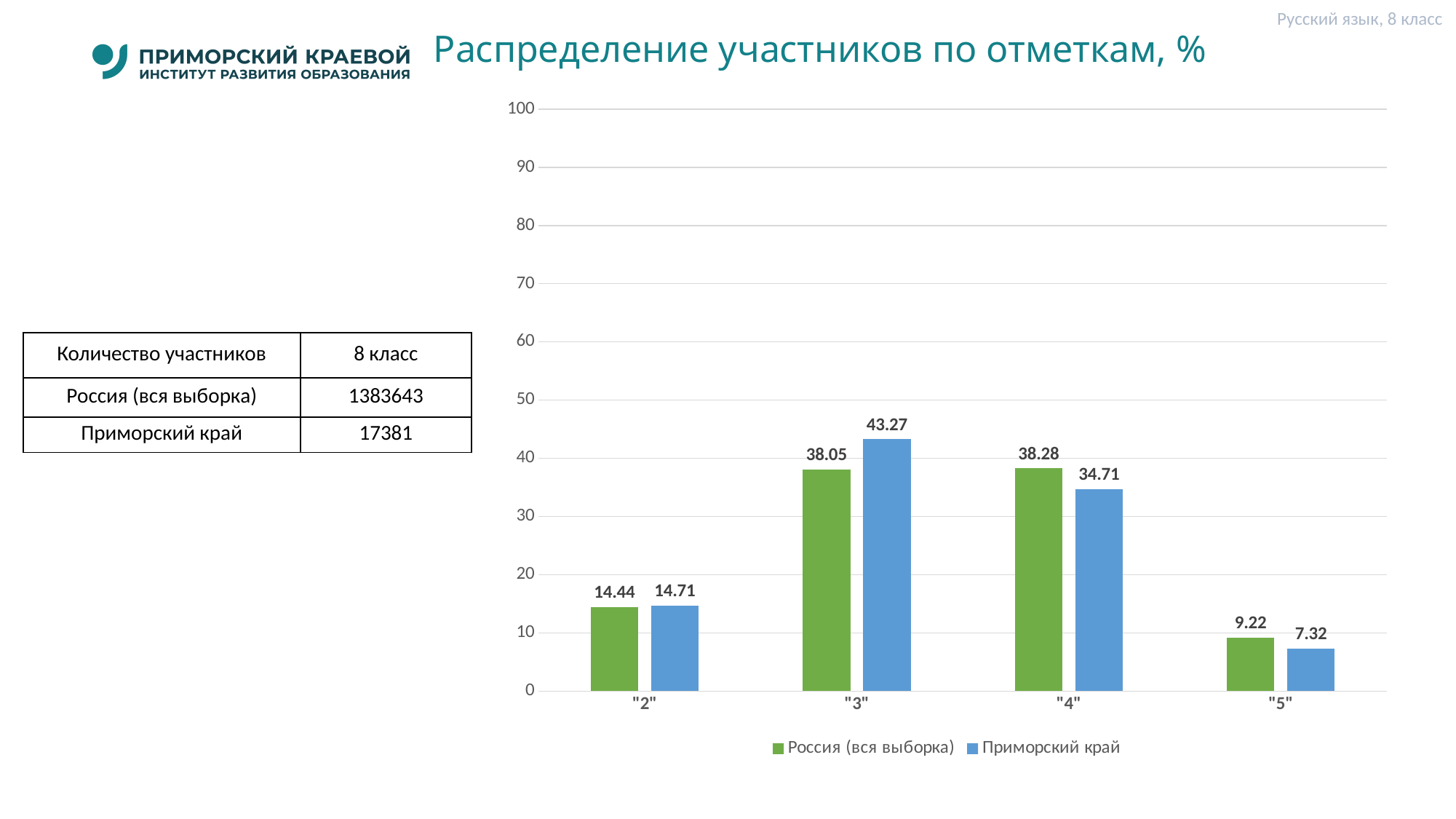
How many mark categories are shown on the x axis? 4 Which mark has the highest value for Приморский край? "3" What is the value for Приморский край at mark "3"? 43.27 What is the title of the chart? Распределение участников по отметкам, % What is the difference between Приморский край and Россия (вся выборка) at mark "3"? 5.22 What kind of chart is shown on the slide? bar chart Is the value for Приморский край at mark "4" greater or less than 30? greater Which mark has the lowest value for Россия (вся выборка)? "5" At mark "4", which series has the larger value: Россия (вся выборка) or Приморский край? Россия (вся выборка) What is the value for Приморский край at mark "5"? 7.32 What is the value for Россия (вся выборка) at mark "4"? 38.28 How many series does the legend list? 2